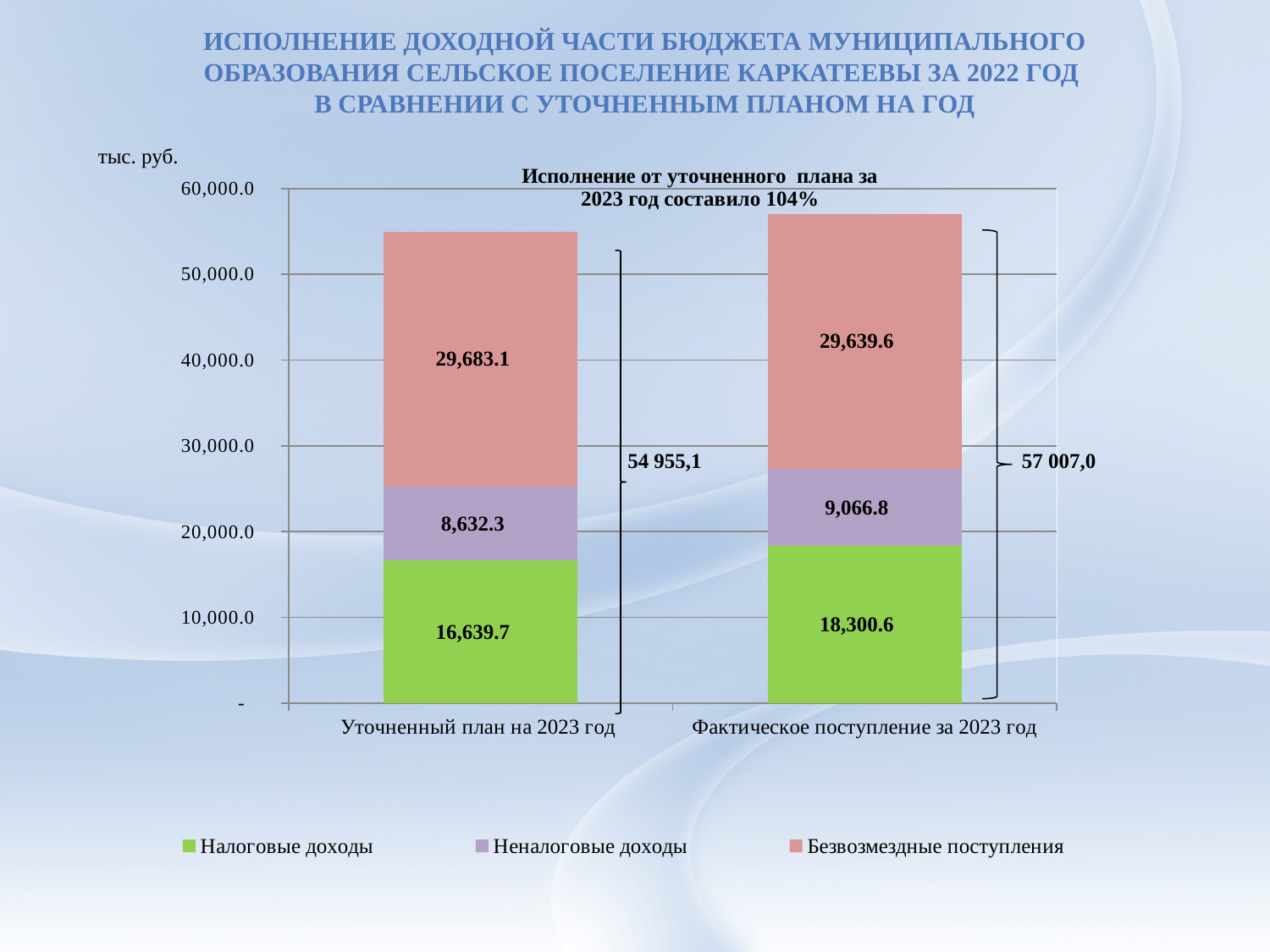
What is the value of Налоговые доходы for Уточненный план на 2023 год? 16,639.7 What is the value of Безвозмездные поступления for Фактическое поступление за 2023 год? 29,639.6 What is the value of Неналоговые доходы for Фактическое поступление за 2023 год? 9,066.8 What is the difference between Налоговые доходы for Фактическое поступление за 2023 год and for Уточненный план на 2023 год? 1,660.9 Which is larger: Неналоговые доходы for Уточненный план на 2023 год or for Фактическое поступление за 2023 год? Фактическое поступление за 2023 год Which series has the highest value in the Фактическое поступление за 2023 год bar? Безвозмездные поступления What kind of chart is shown on the slide? Stacked bar chart How many categories are shown on the x axis? 2 Which series has the lowest value in the Уточненный план на 2023 год bar? Неналоговые доходы How many series does the legend list? 3 What is the total of the stacked bar for Фактическое поступление за 2023 год, as labelled on the slide? 57 007,0 What is the total of the stacked bar for Уточненный план на 2023 год, as labelled on the slide? 54 955,1